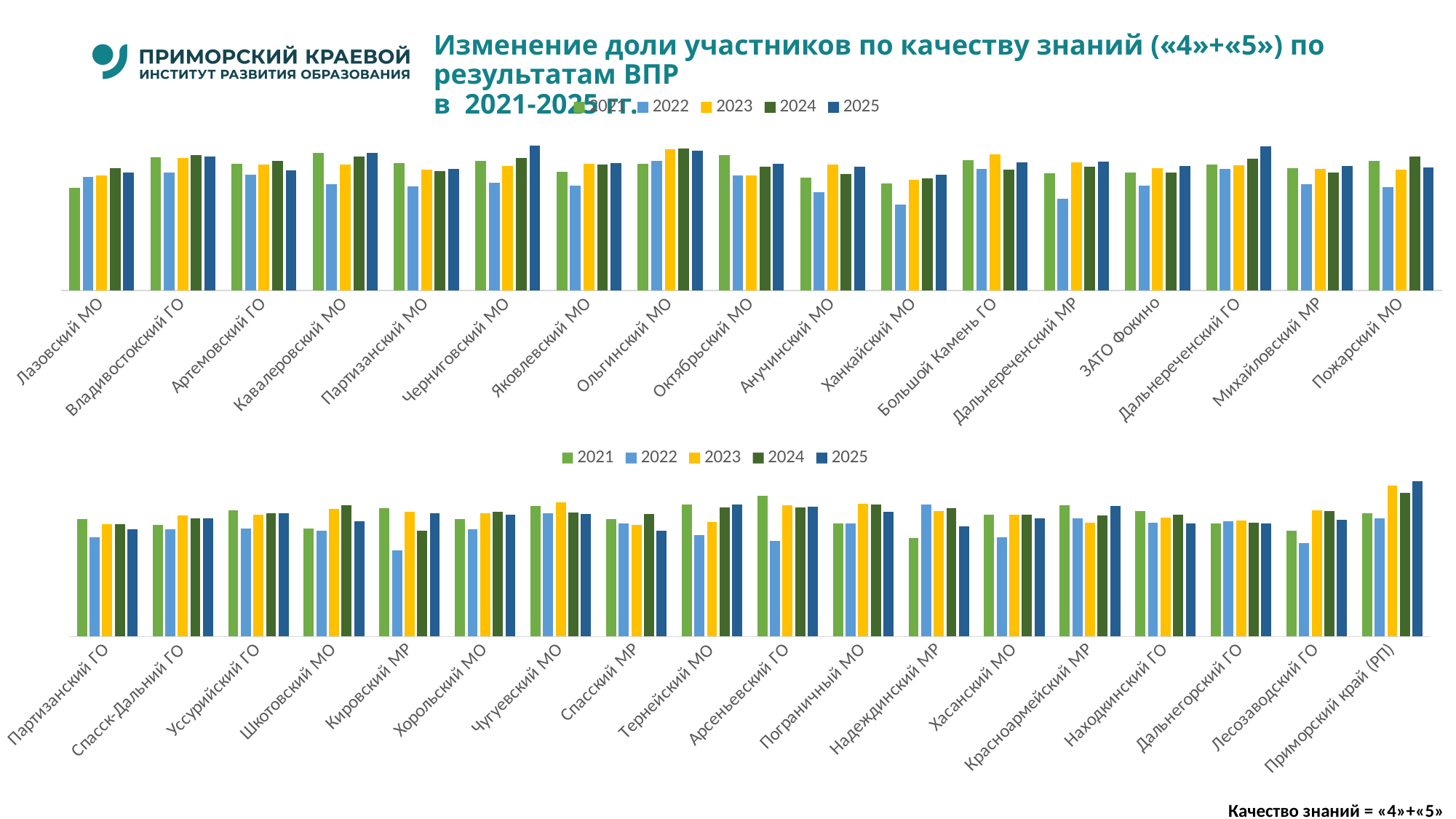
How many municipalities are shown along the x axis of the top chart? 17 In the top chart, which year has the lowest bar for Лазовский МО? 2021 How many series does the legend of the top chart list? 5 In the bottom chart, for Арсеньевский ГО, is the 2021 bar or the 2022 bar higher? 2021 In the bottom chart, which year has the lowest bar for Кировский МР? 2022 In the top chart, which year has the lowest bar for Ханкайский МО? 2022 How many categories are shown along the x axis of the bottom chart? 18 Which colour represents the year 2023 in the legend of the charts? yellow What kind of chart is shown at the top of the slide? bar chart Which years are listed in the legend of the bottom chart? 2021, 2022, 2023, 2024, 2025 In the top chart, for Дальнереченский МР, is the 2022 bar or the 2023 bar higher? 2023 In the bottom chart, which year has the highest bar for Приморский край (РП)? 2025